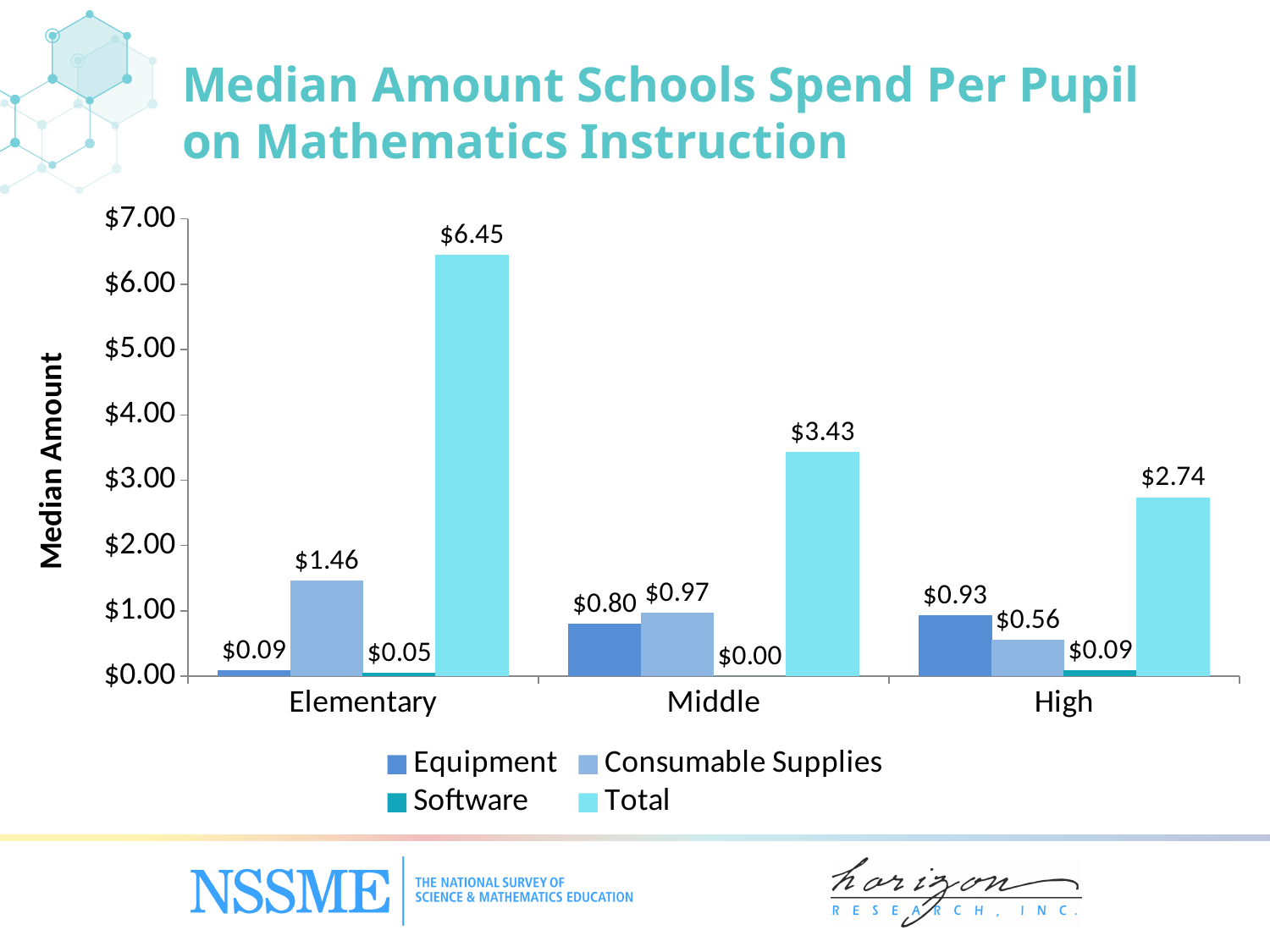
What is the Software value for Middle schools? $0.00 What is the Total median amount spent per pupil for Elementary schools? $6.45 How many series does the legend list? 4 Which is larger, the Consumable Supplies value for Elementary or for High? Elementary What is the Consumable Supplies value for Middle schools? $0.97 Which school level has the highest Total median amount? Elementary What is the Equipment value for High schools? $0.93 How many school levels are shown on the x axis? 3 Which school level has the lowest Total median amount? High What is the difference between the Total for Elementary and the Total for Middle? $3.02 What kind of chart is shown on the slide? Bar chart Is the Total value for Middle schools greater or less than $3.00? greater